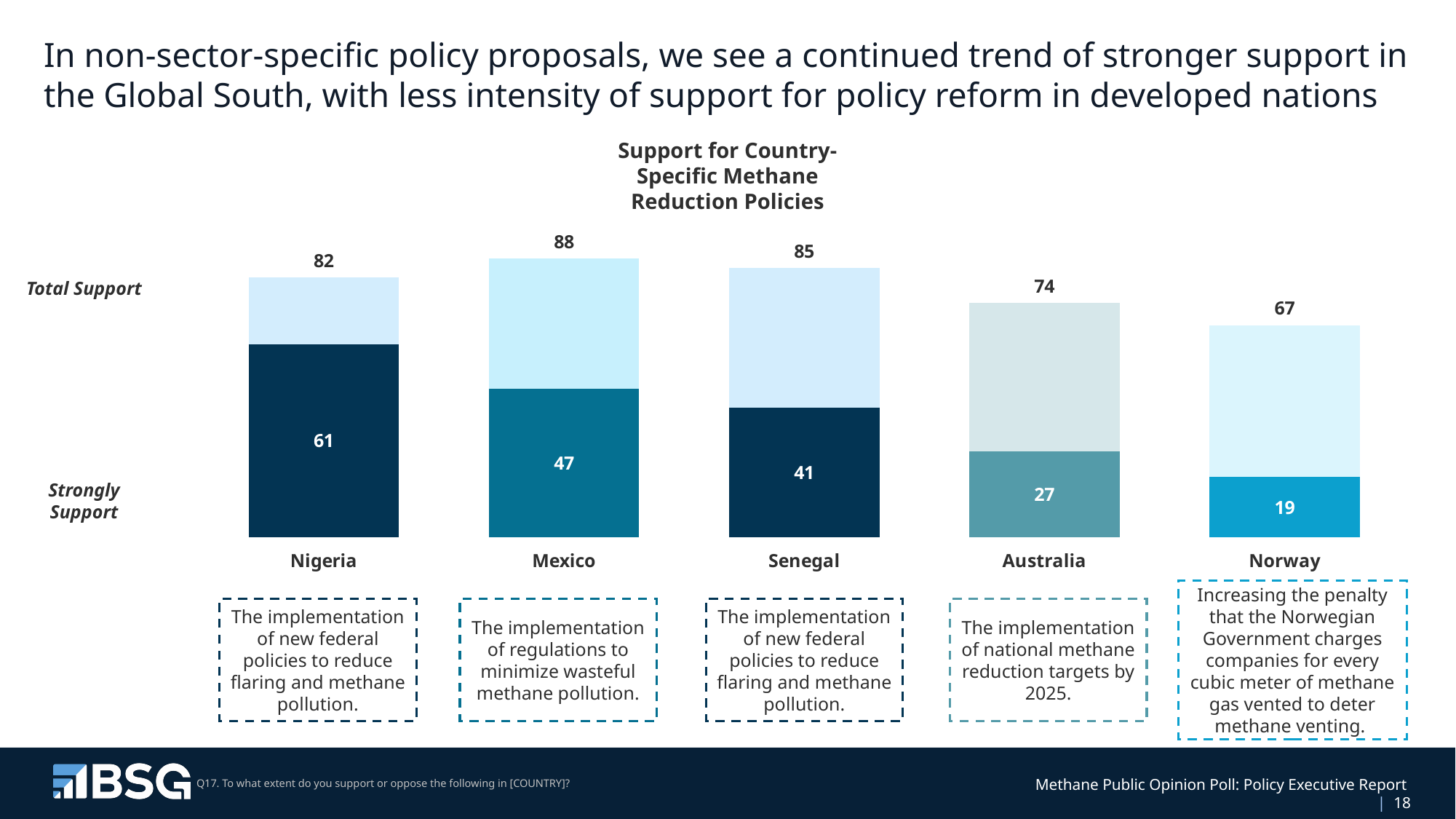
What is the Strongly Support value for Norway? 19 What is the difference between Total Support and Strongly Support for Senegal? 44 What is the Total Support value for Mexico? 88 How many countries are shown in the chart? 5 Which is larger, the Total Support for Senegal or for Australia? Senegal Which country has the highest Strongly Support value? Nigeria What is the Strongly Support value for Nigeria? 61 Which country has the highest Total Support? Mexico How much higher is Nigeria's Strongly Support value than Mexico's? 14 What is the Total Support value for Australia? 74 Which country has the lowest Strongly Support value? Norway What type of chart is shown on the slide? Stacked bar chart